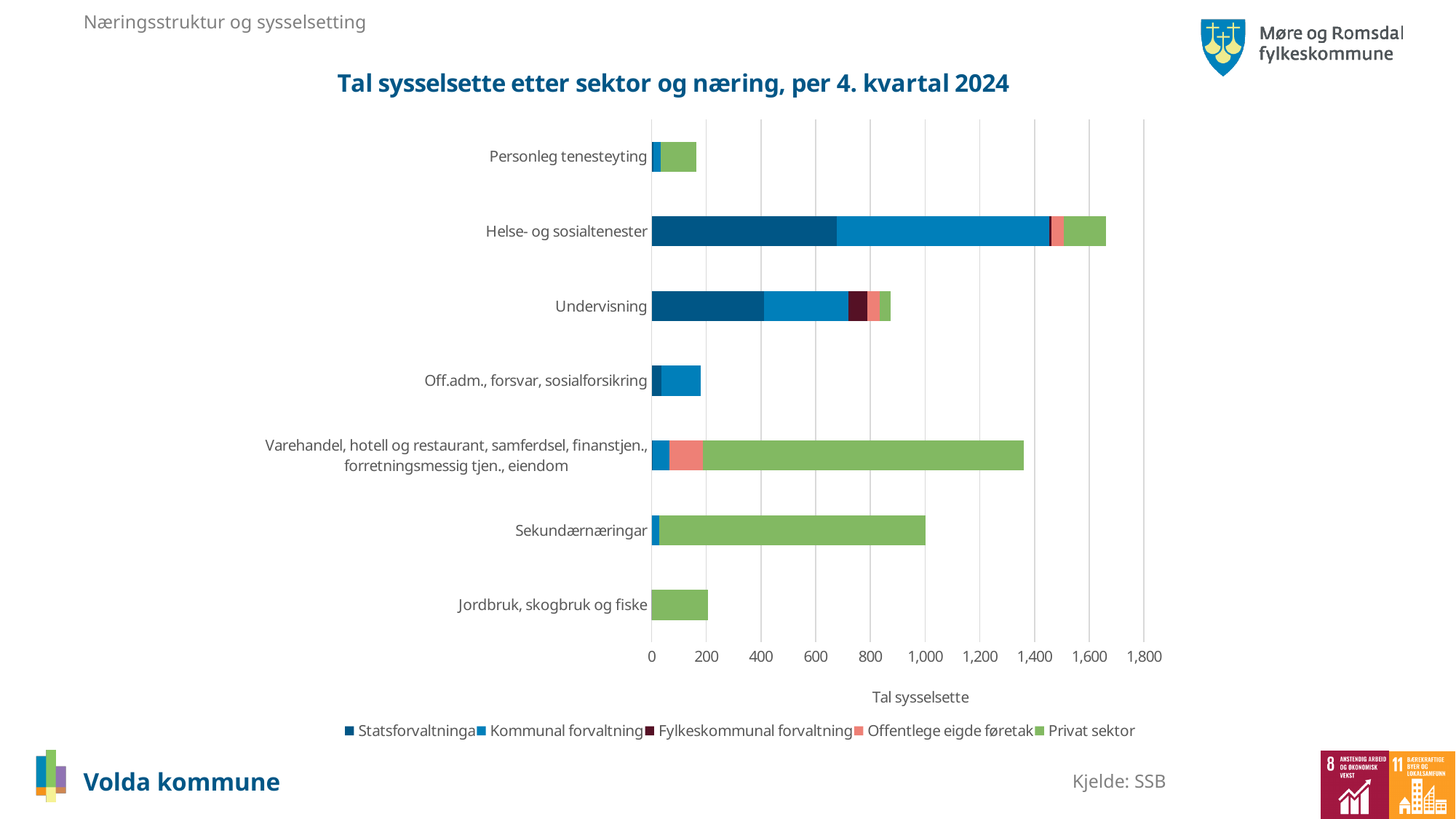
Which has the larger total bar: Varehandel, hotell og restaurant, samferdsel, finanstjen., forretningsmessig tjen., eiendom or Sekundærnæringar? Varehandel, hotell og restaurant, samferdsel, finanstjen., forretningsmessig tjen., eiendom Which series is shown in green in the legend? Privat sektor Is the total value for Varehandel, hotell og restaurant, samferdsel, finanstjen., forretningsmessig tjen., eiendom greater or less than 1,400? less Is the total value for Personleg tenesteyting greater or less than 200? less How many series does the legend list? 5 Which category has the longest total bar? Helse- og sosialtenester How many categories (næringar) are plotted on the y axis? 7 Is the total value for Helse- og sosialtenester greater or less than 1,400? greater What is the title of the chart? Tal sysselsette etter sektor og næring, per 4. kvartal 2024 What kind of chart is shown on the slide? Stacked bar chart